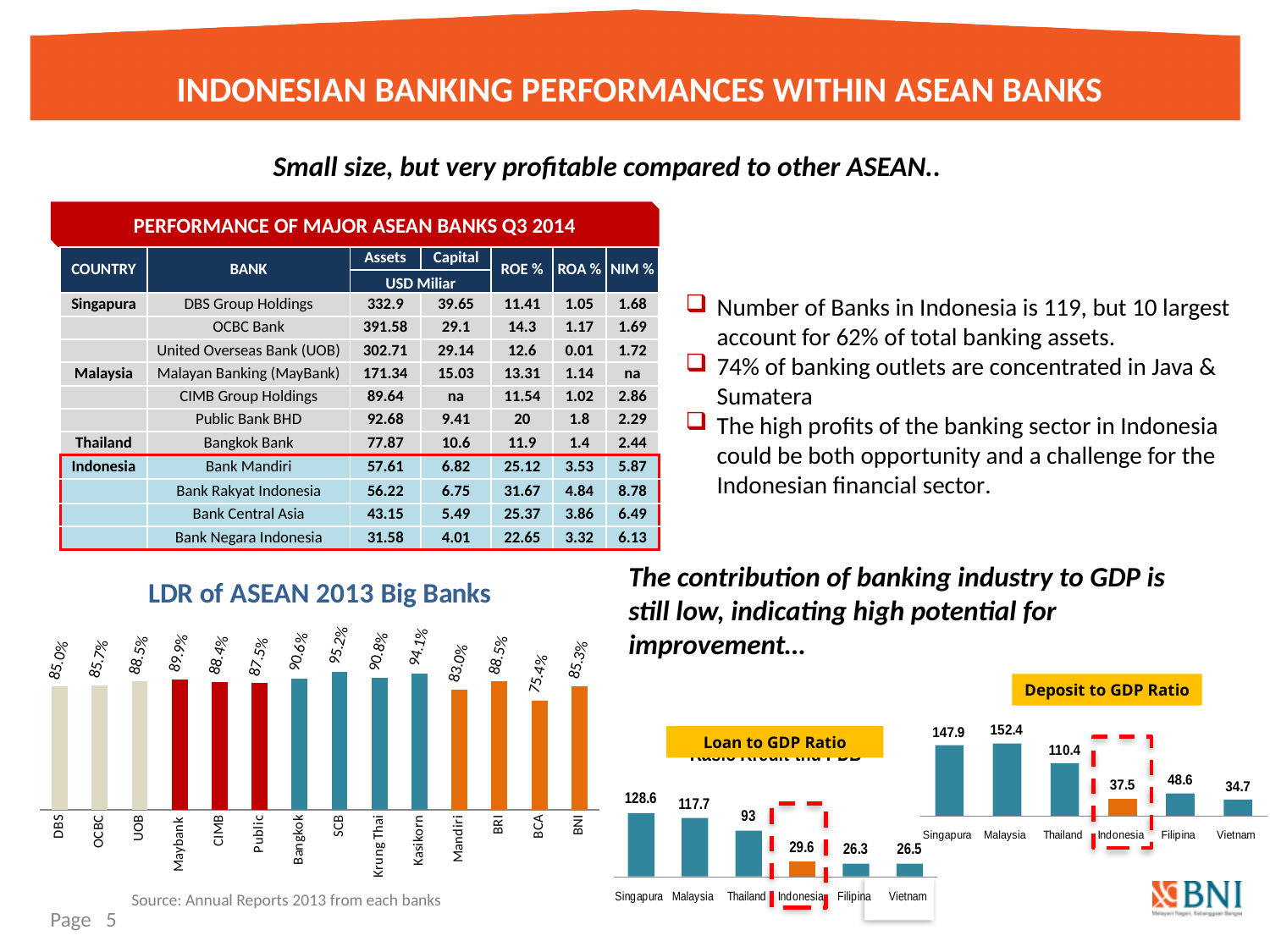
In the 'Deposit to GDP Ratio' chart, which country has the highest value? Malaysia In the 'Loan to GDP Ratio' chart, what is the value for Indonesia? 29.6 In the 'LDR of ASEAN 2013 Big Banks' chart, which is larger, the LDR of Maybank or of BNI? Maybank What type of chart is the 'Deposit to GDP Ratio' chart? Bar chart In the 'Loan to GDP Ratio' chart, which country has the highest value? Singapura In the 'LDR of ASEAN 2013 Big Banks' chart, what is the difference between the LDR of Kasikorn and Mandiri? 11.1% In the 'LDR of ASEAN 2013 Big Banks' chart, which bank has the lowest LDR? BCA In the 'LDR of ASEAN 2013 Big Banks' chart, how many banks are shown? 14 In the 'LDR of ASEAN 2013 Big Banks' chart, which bank has the highest LDR? SCB In the 'LDR of ASEAN 2013 Big Banks' chart, what is the LDR value for SCB? 95.2% In the 'Deposit to GDP Ratio' chart, what is the value for Filipina? 48.6 In the 'Loan to GDP Ratio' chart, what is the difference between Singapura and Malaysia? 10.9